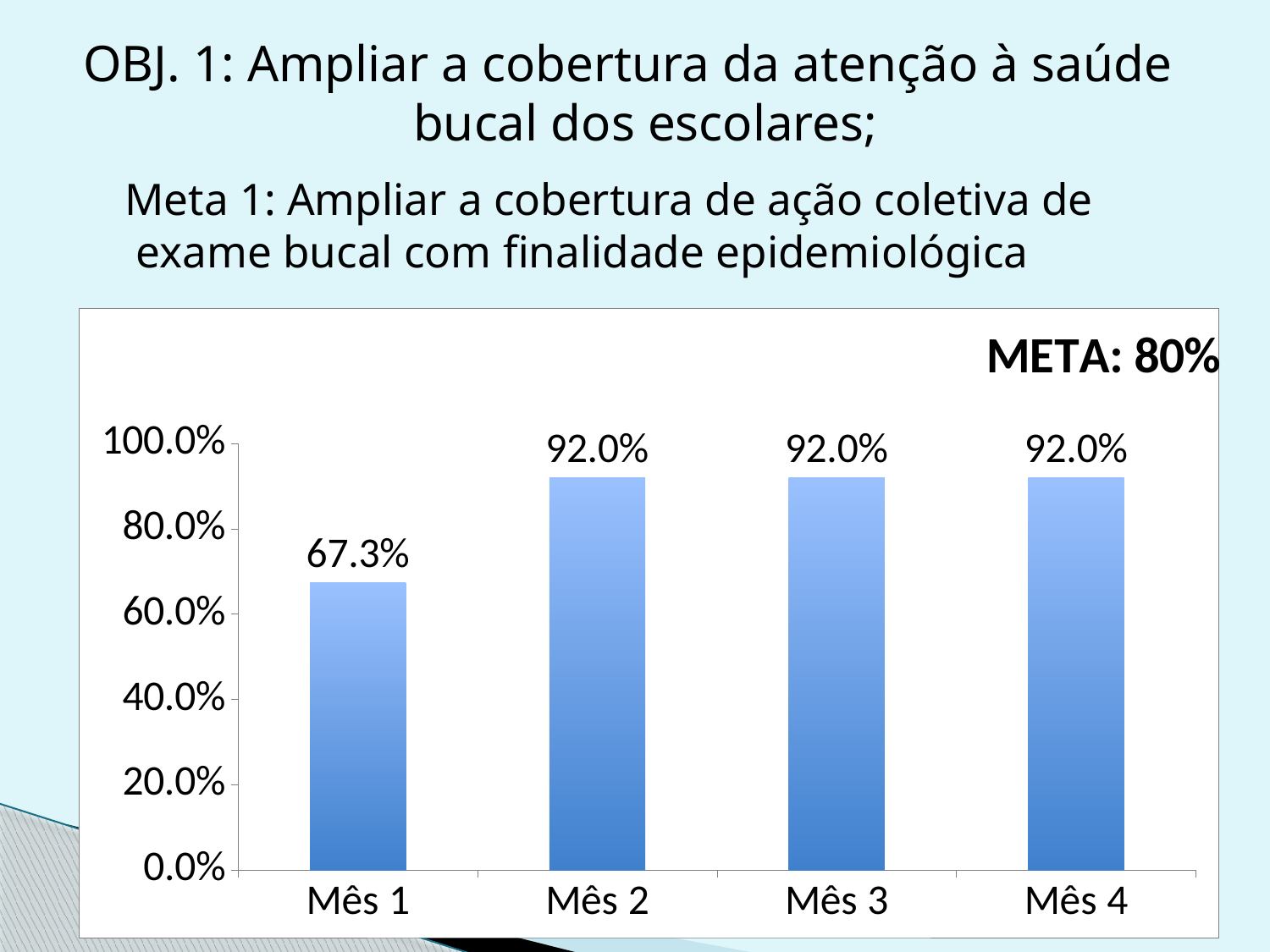
Which is larger, the value for Mês 1 or the value for Mês 3? Mês 3 Is the value for Mês 1 greater or less than 80%? less What kind of chart is shown on the slide? bar chart What target (META) is stated on the chart? 80% Do the values rise or fall from Mês 1 to Mês 2? rise What is the value for Mês 2? 92.0% What is the value for Mês 1? 67.3% What is the difference between the values for Mês 2 and Mês 1? 24.7% What is the value for Mês 4? 92.0% Which month has the lowest value? Mês 1 Is the value for Mês 3 greater or less than 80%? greater How many months are shown on the x axis? 4